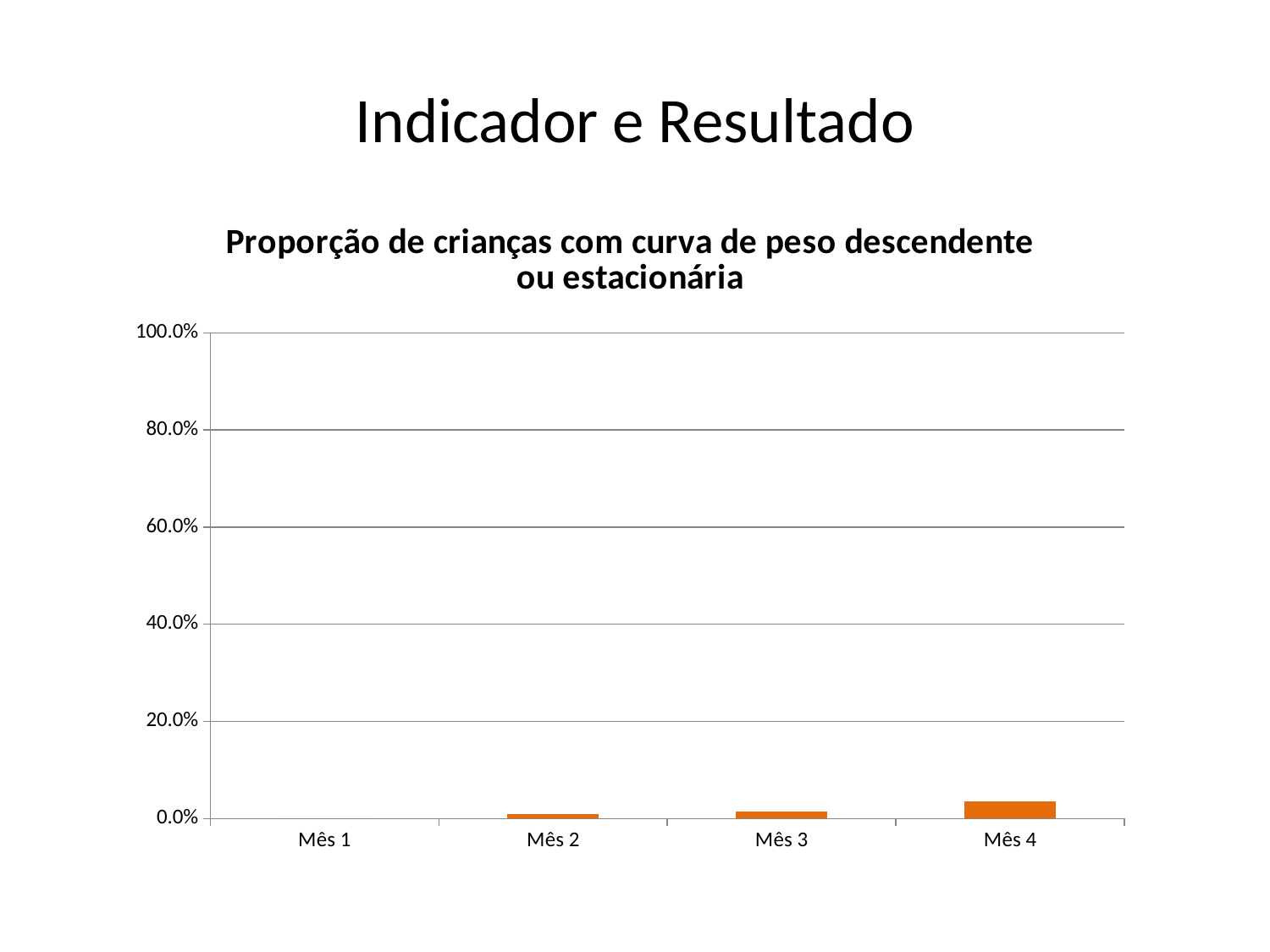
What is the title of the chart? Proporção de crianças com curva de peso descendente ou estacionária Which month has the lowest value in the chart? Mês 1 Is the value for Mês 3 greater or less than 20.0%? less Do the values rise or fall from Mês 1 to Mês 4? rise What kind of chart is shown on the slide? bar chart Is the value for Mês 2 greater or less than 40.0%? less What is the highest value shown on the y axis of the chart? 100.0% Which is larger, the value for Mês 3 or the value for Mês 1? Mês 3 How many categories are shown on the x axis of the chart? 4 Which is larger, the value for Mês 4 or the value for Mês 2? Mês 4 Which month has the highest value in the chart? Mês 4 Is the value for Mês 4 greater or less than 20.0%? less